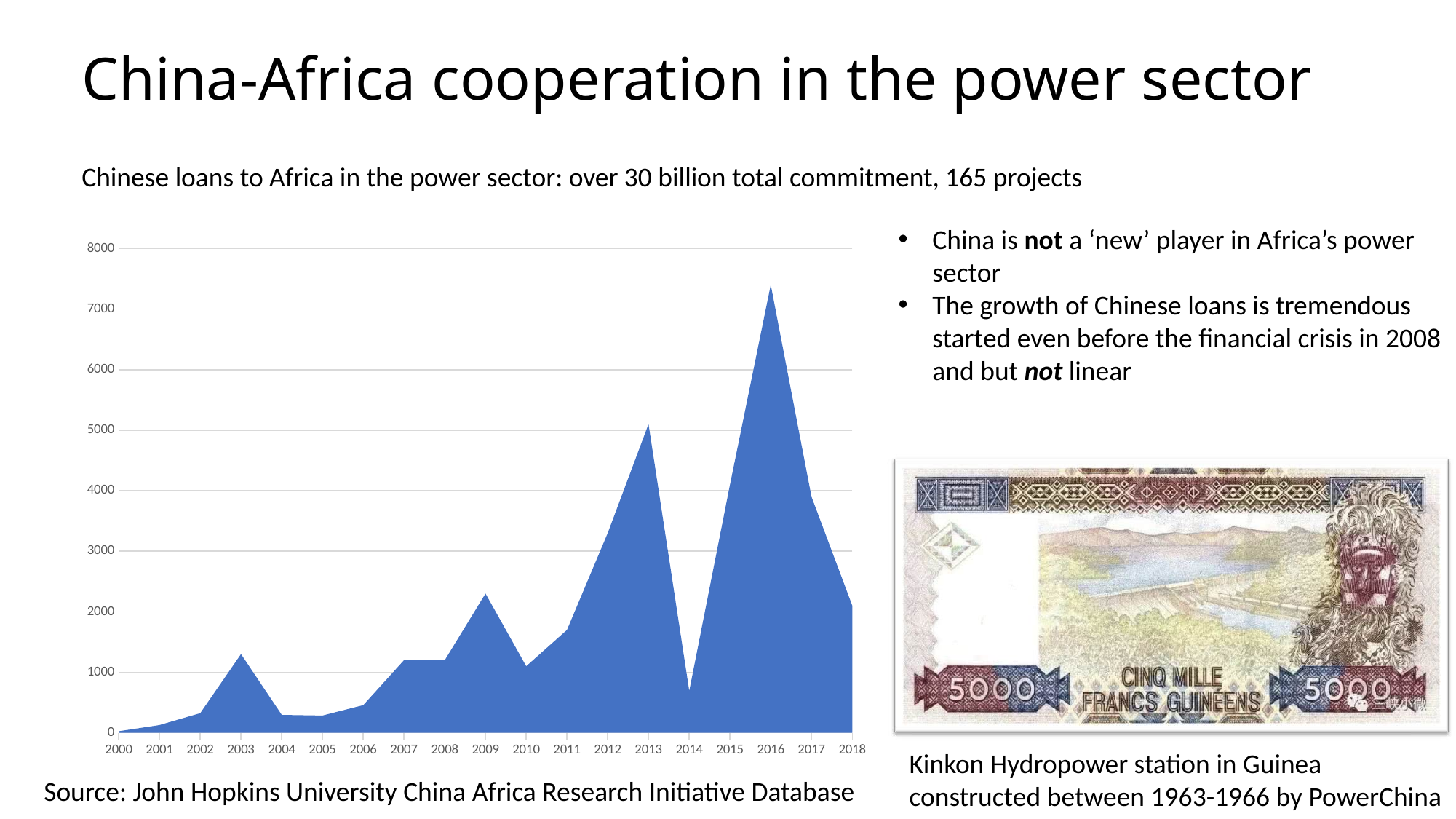
Which year has the lowest value in the chart? 2000 Which year has the larger value, 2013 or 2016? 2016 Is the value for 2013 greater or less than 4000? greater Which year has the highest value in the chart? 2016 Do the values rise or fall from 2016 to 2018? fall What kind of chart is shown on the slide? area chart Is the value for 2005 greater or less than 1000? less Is the value for 2014 greater or less than 1000? less Which year has the larger value, 2003 or 2009? 2009 How many years are shown on the x axis of the chart? 19